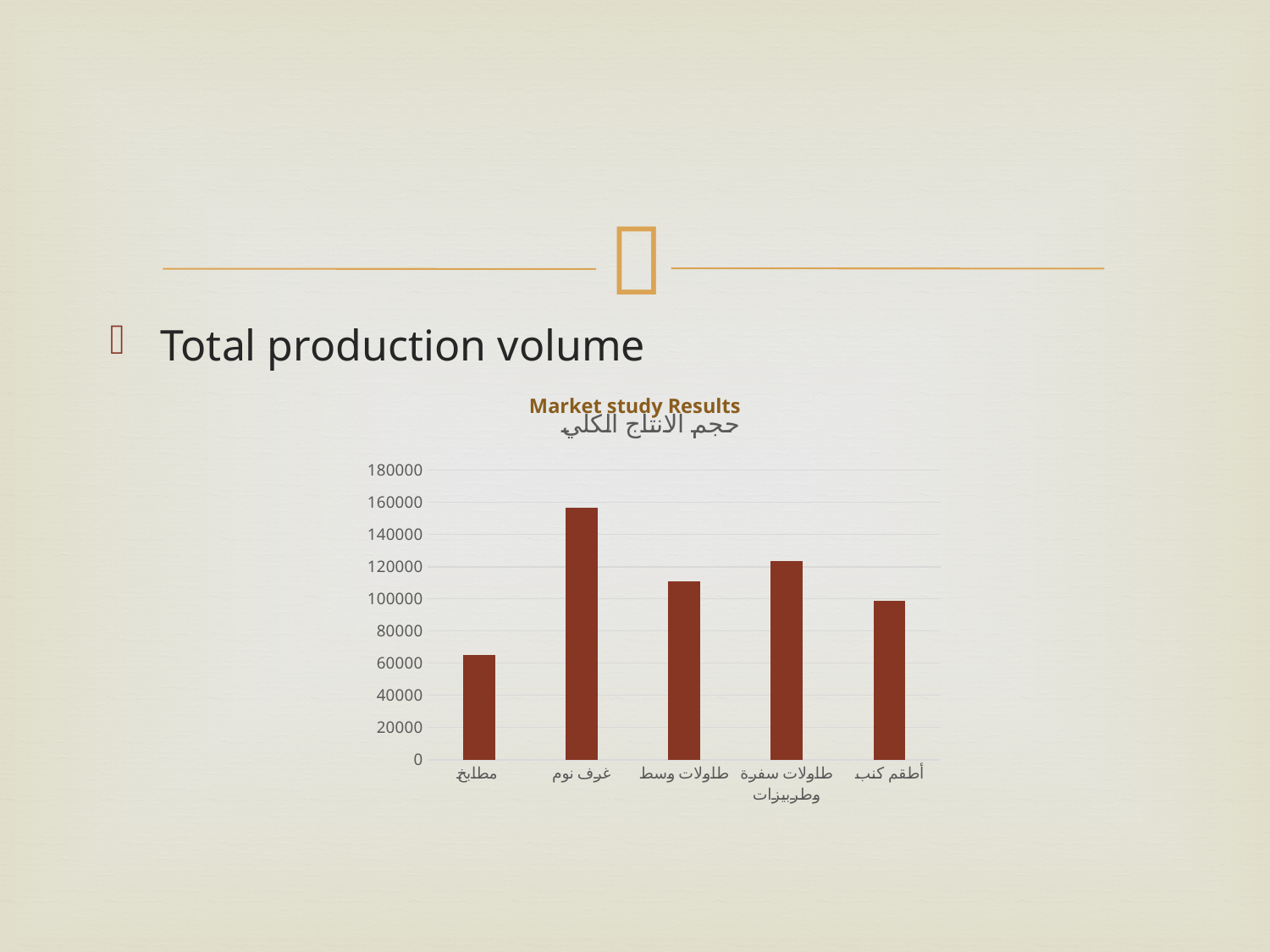
Is the value for مطابخ greater or less than 80000? less Is the value for غرف نوم greater or less than 140000? greater Which is larger, the value for مطابخ or the value for أطقم كنب? أطقم كنب Which category has the highest bar in the chart? غرف نوم Which category has the lowest bar in the chart? مطابخ What is the highest value shown on the vertical axis of the chart? 180000 How many categories are plotted in the chart? 5 What is the English title shown above the chart? Market study Results Which is larger, the value for طاولات وسط or the value for طاولات سفرة وطربيزات? طاولات سفرة وطربيزات What kind of chart is shown on the slide? bar chart